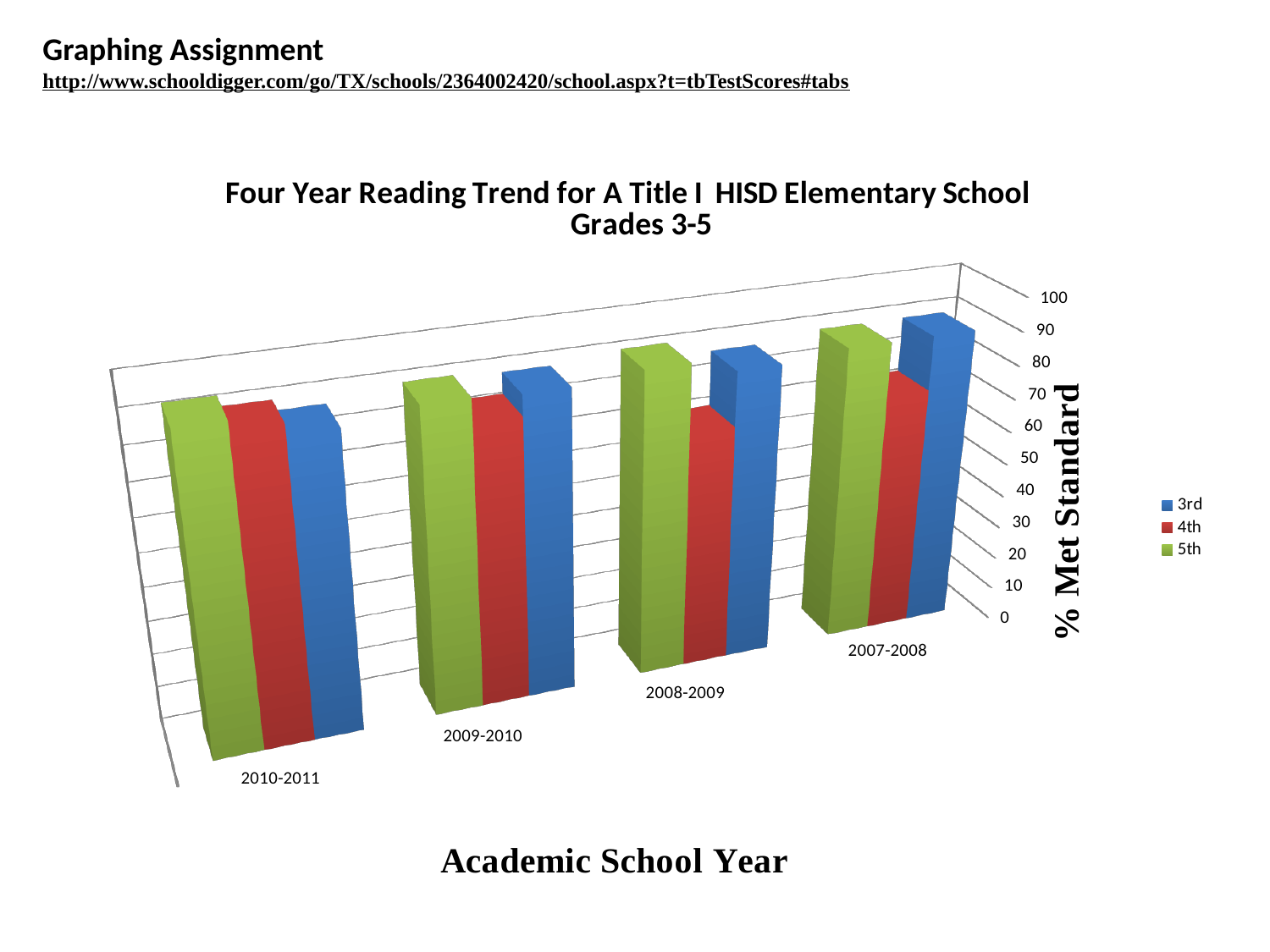
For 2008-2009, which is larger: the 5th grade value or the 4th grade value? 5th In the 2009-2010 group, which grade has the lowest bar? 4th For 2007-2008, which is larger: the 3rd grade value or the 4th grade value? 3rd Is the 3rd grade value for 2007-2008 greater or less than 50? greater Which colour represents the 4th grade series in the chart legend? red Is the 4th grade value for 2008-2009 greater or less than 30? greater What is the title of the vertical axis of the chart? % Met Standard What type of chart is shown on the slide? bar chart In the 2008-2009 group, which grade has the lowest bar? 4th How many academic school years are shown on the x axis of the chart? 4 How many series does the chart legend list? 3